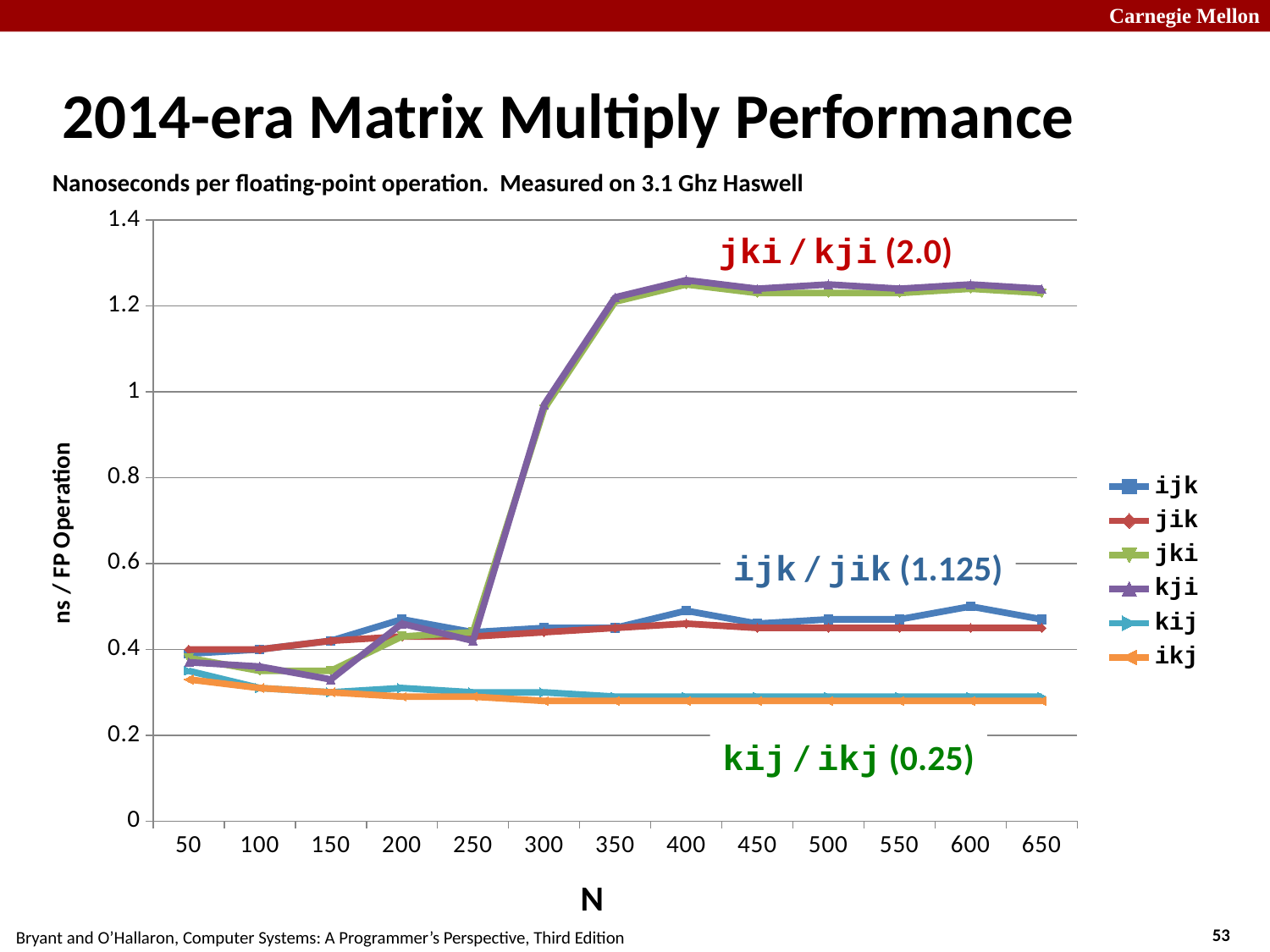
At N = 650, which is larger, the value for ijk or the value for kij? ijk Is the value for kji at N = 400 greater or less than 1.2? greater Is the value for ijk at N = 600 greater or less than 0.6? less Is the value for jki at N = 250 greater or less than 0.8? less What kind of chart is shown on the slide? line chart Which series has the highest value at N = 650? kji What is the label on the y axis? ns / FP Operation How many series does the legend list? 6 How many values of N are marked along the x axis? 13 Which series has the lowest value at N = 650? ikj Does the jki series rise or fall between N = 250 and N = 350? rise